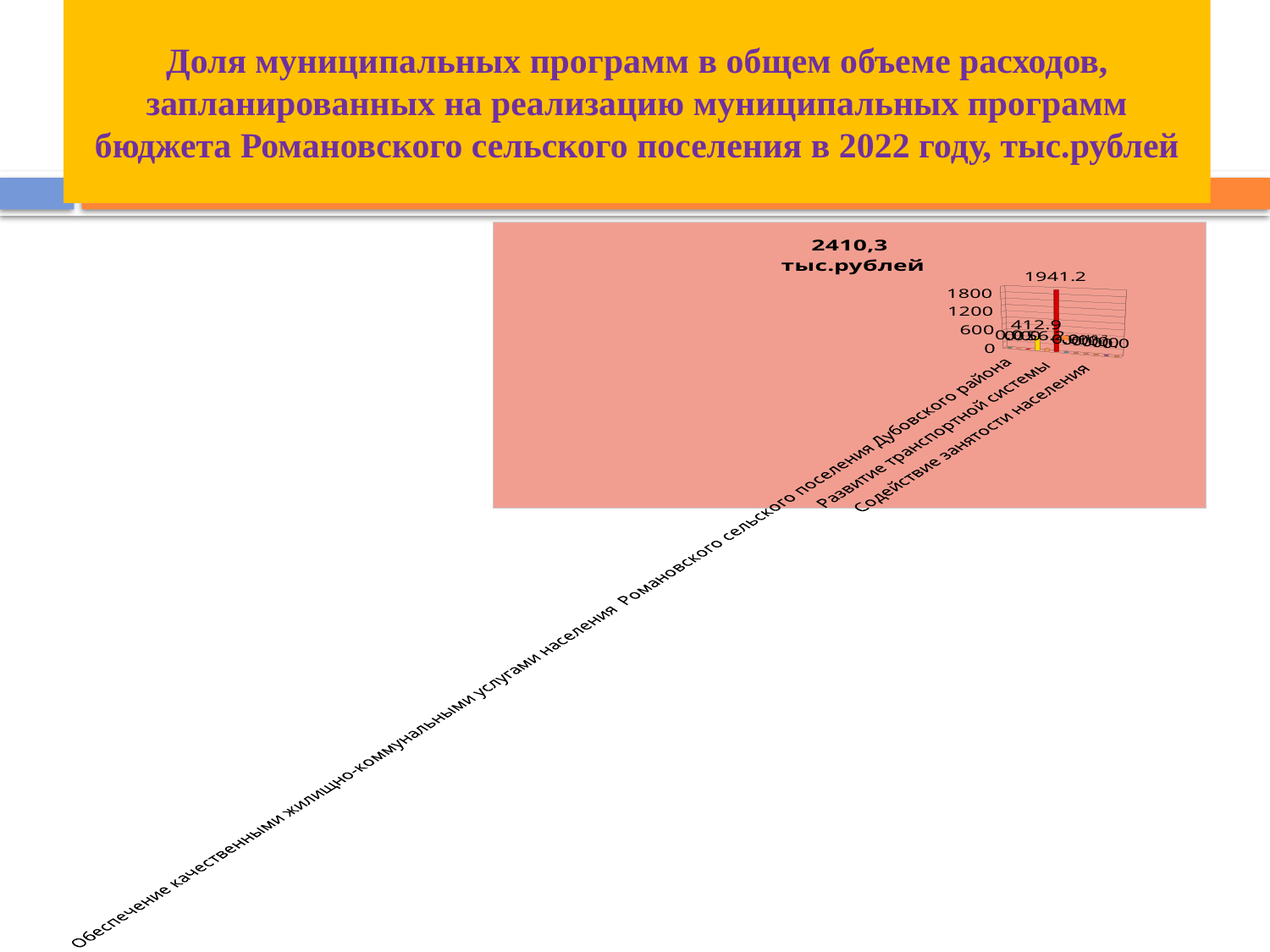
What is the value for Обеспечение качественными жилищно-коммунальными услугами населения Романовского сельского поселения Дубовского района? 0 Is the value for Развитие транспортной системы greater or less than 1800? less Which is larger: the value for Развитие транспортной системы or the value for Обеспечение качественными жилищно-коммунальными услугами населения? Развитие транспортной системы What kind of chart is shown on the slide? bar chart Is the value for Обеспечение качественными жилищно-коммунальными услугами населения greater or less than 600? less What is the title shown above the chart? 2410,3 тыс.рублей